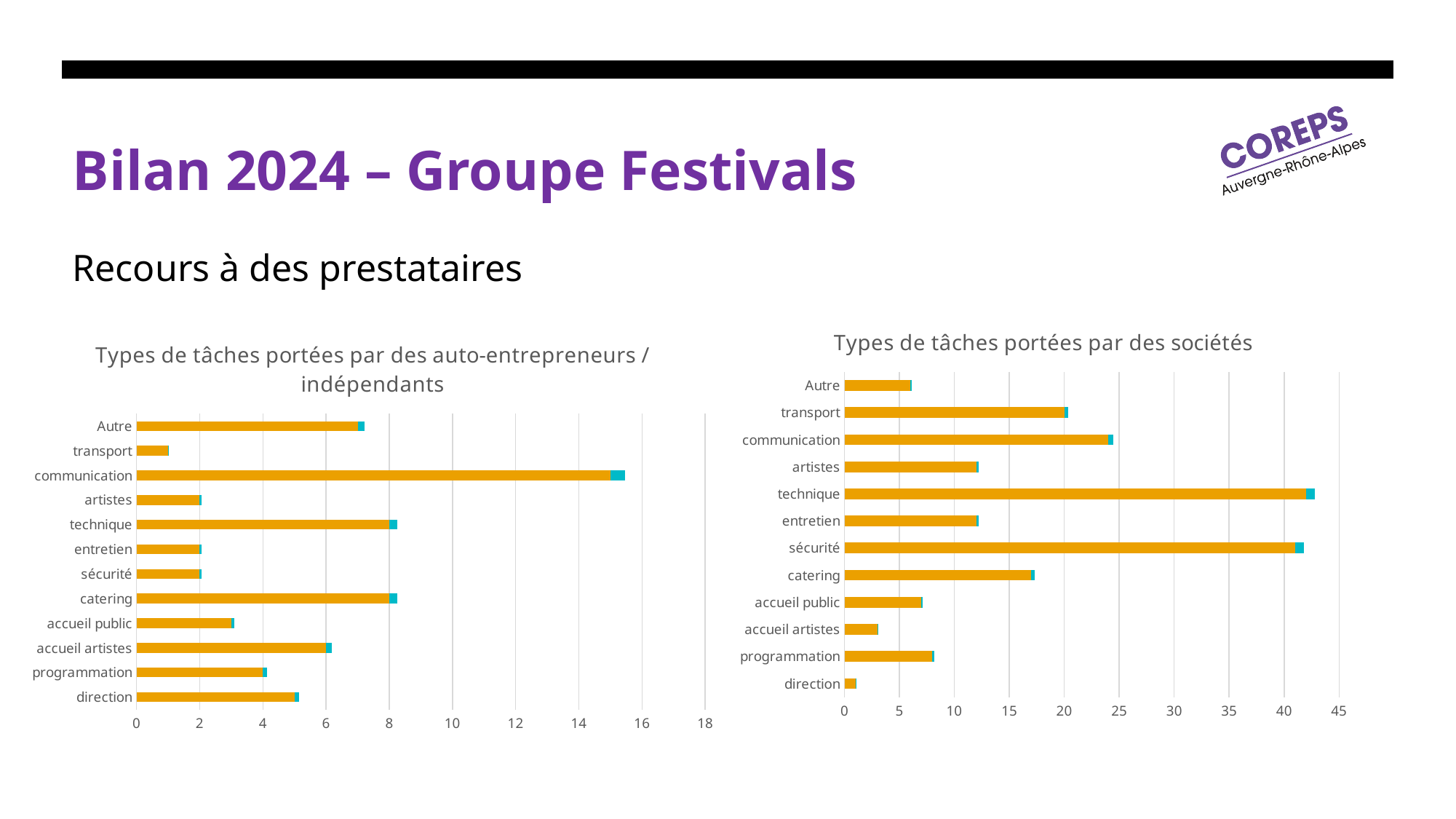
In the 'Types de tâches portées par des sociétés' chart, is the value for catering greater or less than 20? less How many categories are shown in the 'Types de tâches portées par des sociétés' chart? 12 In the 'Types de tâches portées par des sociétés' chart, is the value for accueil artistes greater or less than 5? less In the 'Types de tâches portées par des sociétés' chart, which category has the lowest value? direction In the 'Types de tâches portées par des sociétés' chart, which is larger: communication or transport? communication In the 'Types de tâches portées par des auto-entrepreneurs / indépendants' chart, which category has the lowest value? transport In the 'Types de tâches portées par des auto-entrepreneurs / indépendants' chart, which category has the highest value? communication What is the title of the chart on the right side of the slide? Types de tâches portées par des sociétés What type of chart is the 'Types de tâches portées par des sociétés' chart? bar chart In the 'Types de tâches portées par des auto-entrepreneurs / indépendants' chart, is the value for communication greater or less than 14? greater In the 'Types de tâches portées par des auto-entrepreneurs / indépendants' chart, which is larger: accueil artistes or accueil public? accueil artistes